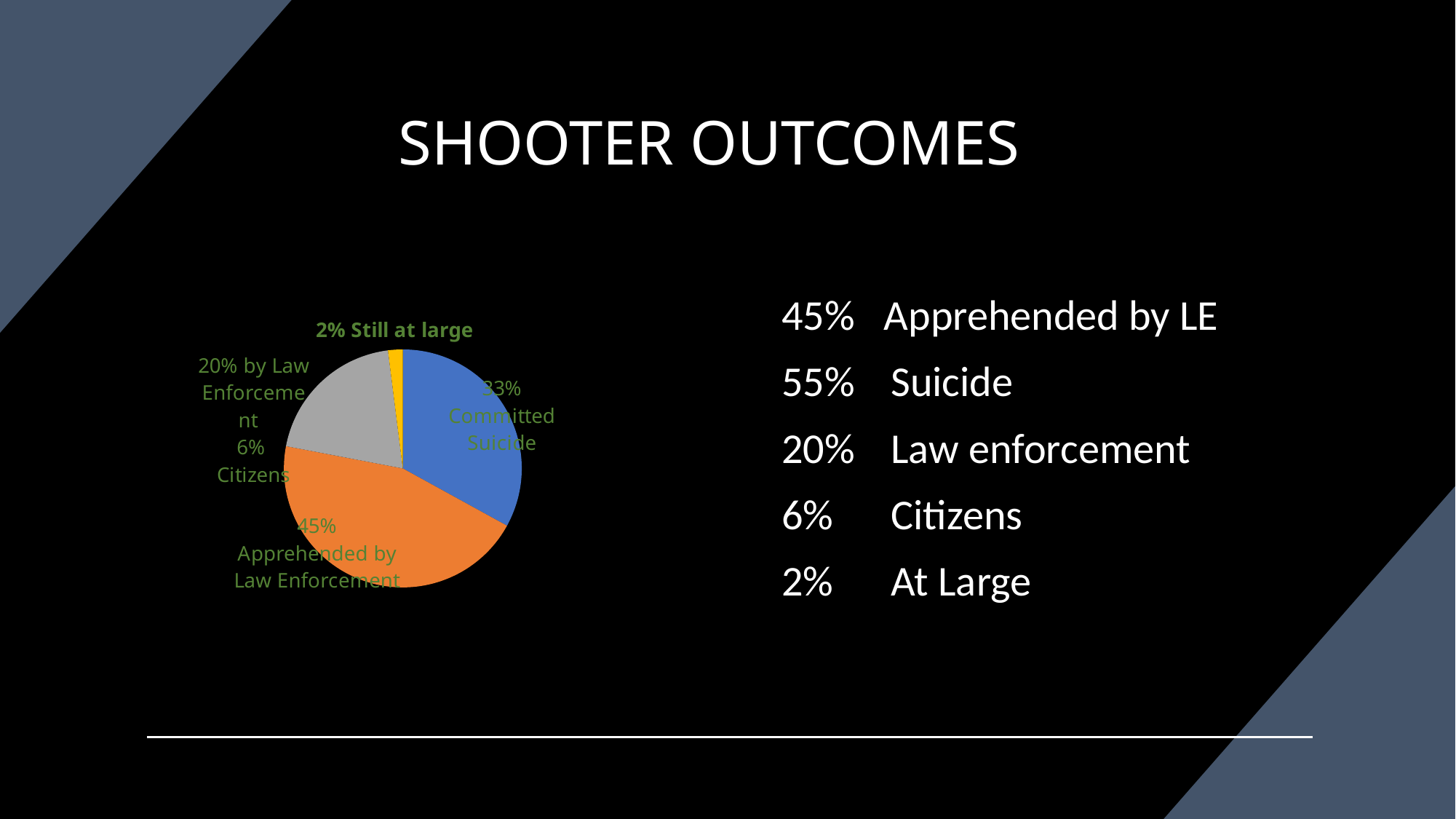
In the pie chart, which is larger: the Apprehended by Law Enforcement slice or the Committed Suicide slice? Apprehended by Law Enforcement What type of chart is shown on the slide? Pie chart In the pie chart, how many percentage points larger is Apprehended by Law Enforcement than Still at large? 43 What is the title of the slide containing the pie chart? SHOOTER OUTCOMES What percentage of the pie chart is labelled Apprehended by Law Enforcement? 45% In the pie chart, which is larger: the Committed Suicide slice or the Still at large slice? Committed Suicide Which slice of the pie chart is the smallest? Still at large Which slice of the pie chart is the largest? Apprehended by Law Enforcement What percentage of the pie chart is labelled Committed Suicide? 33% In the pie chart, how many percentage points larger is Apprehended by Law Enforcement than Committed Suicide? 12 What percentage of the pie chart is labelled Still at large? 2% What colour is the Still at large slice in the pie chart? Yellow